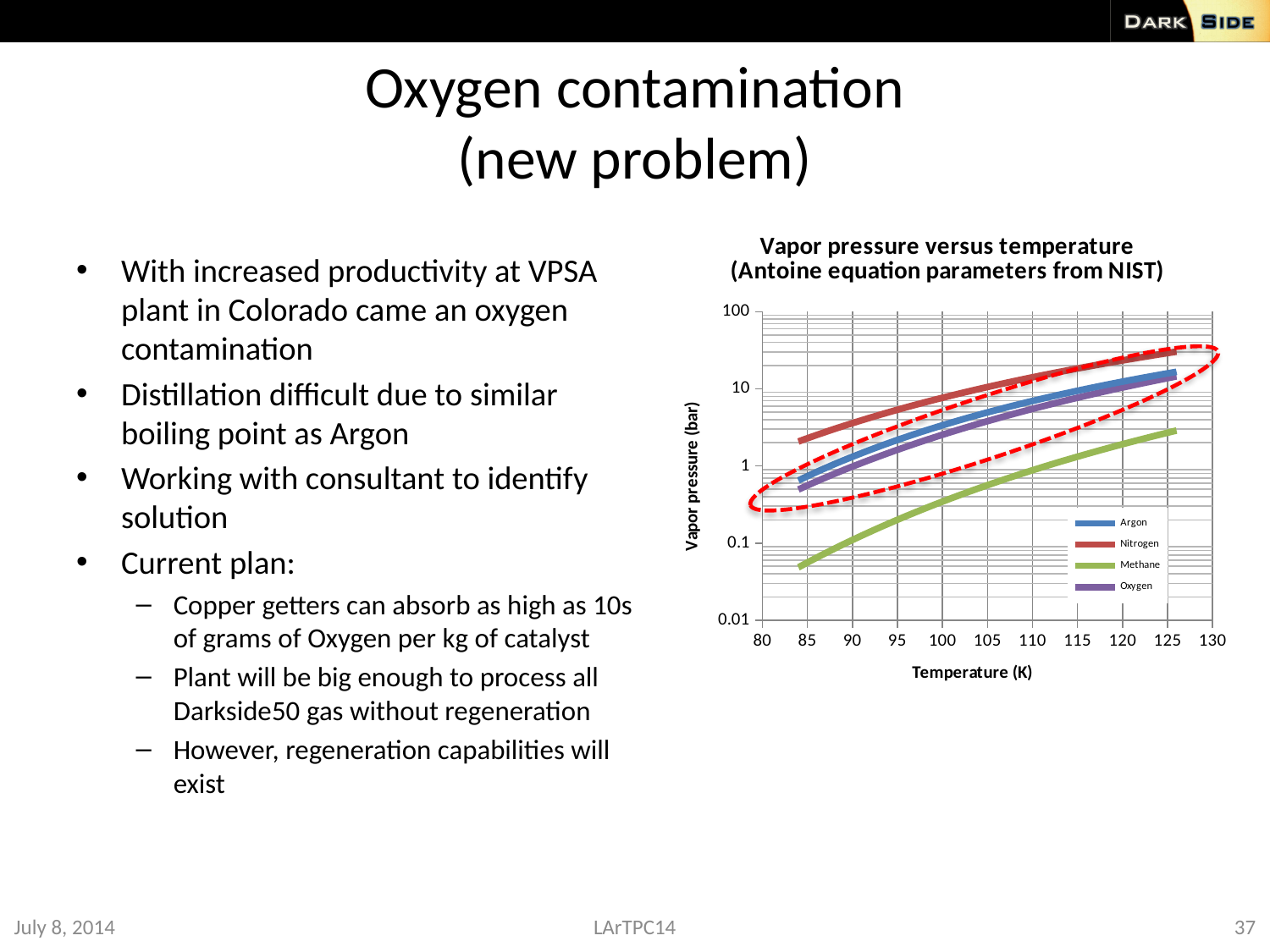
Which series has the lowest vapor pressure across the plotted temperature range? Methane At 100 K, which has the larger vapor pressure, Nitrogen or Methane? Nitrogen What kind of chart is shown on the slide? line chart Do the vapor pressure curves rise or fall as temperature increases? rise At 110 K, which has the larger vapor pressure, Argon or Methane? Argon How many series does the legend of the vapor pressure chart list? 4 Is the vapor pressure of Argon at 125 K greater or less than 10 bar? greater Is the vapor pressure of Methane at 85 K greater or less than 0.1 bar? less Which series are listed in the legend of the vapor pressure chart? Argon, Nitrogen, Methane, Oxygen Which series has the highest vapor pressure across the plotted temperature range? Nitrogen Is the vapor pressure of Methane at 125 K greater or less than 1 bar? greater What is the title of the y axis of the chart? Vapor pressure (bar)